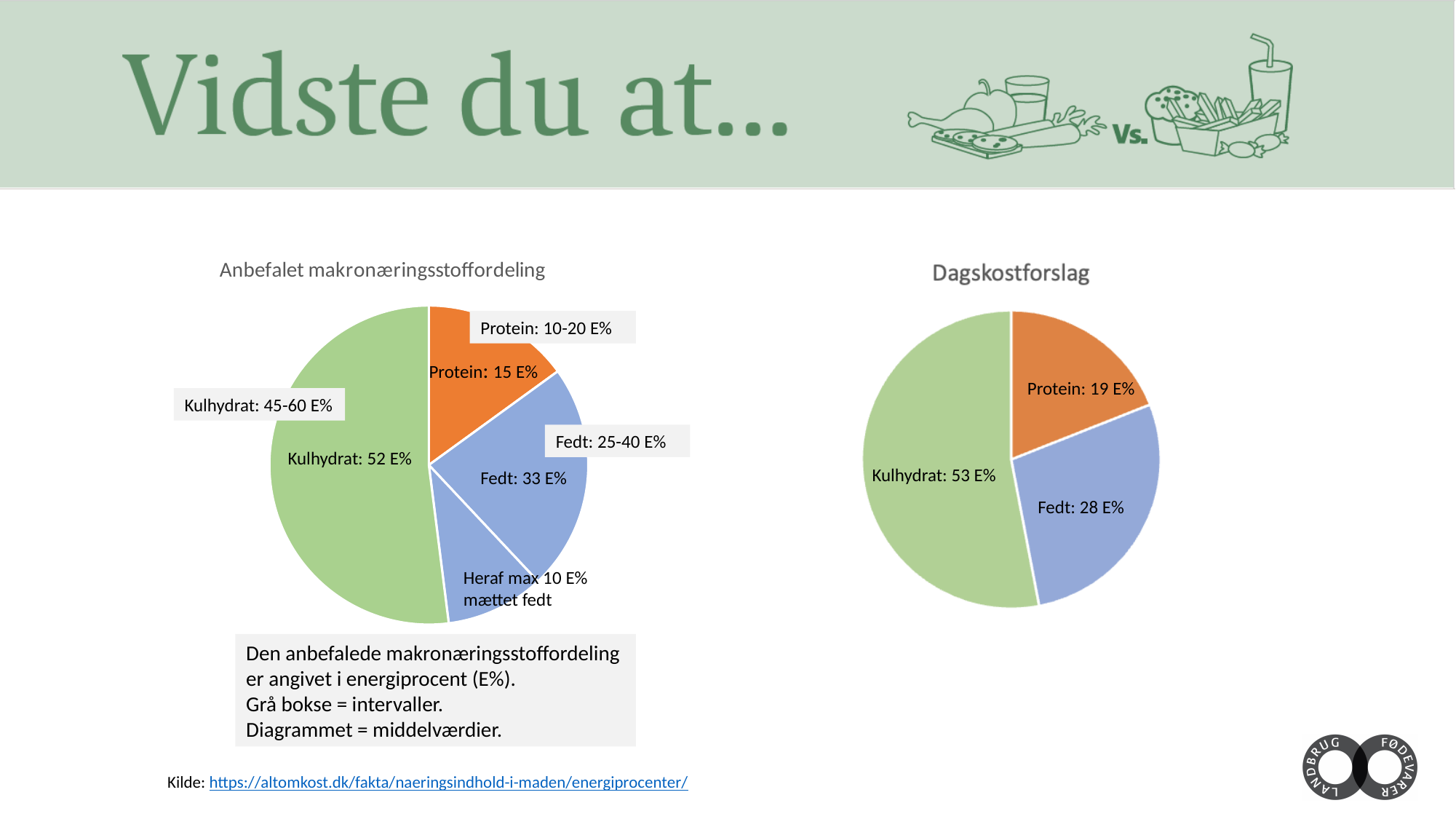
What kind of chart is the 'Dagskostforslag' chart? Pie chart In the 'Dagskostforslag' chart, which category has the largest slice? Kulhydrat In the 'Anbefalet makronæringsstoffordeling' chart, which category has the smallest slice? Mættet fedt (Heraf max 10 E% mættet fedt) In the 'Anbefalet makronæringsstoffordeling' chart, what is the value for Fedt? 33 E% In the 'Anbefalet makronæringsstoffordeling' chart, what interval is given in the grey box for Kulhydrat? 45-60 E% Which is larger: Protein in the 'Dagskostforslag' chart or Protein in the 'Anbefalet makronæringsstoffordeling' chart? Dagskostforslag In the 'Dagskostforslag' chart, what is the value for Protein? 19 E% In the 'Anbefalet makronæringsstoffordeling' chart, what is the value for Kulhydrat? 52 E% In the 'Dagskostforslag' chart, what is the difference between Kulhydrat and Fedt? 25 E% How many categories are shown in the 'Dagskostforslag' chart? 3 In the 'Dagskostforslag' chart, what is the value for Fedt? 28 E% In the 'Anbefalet makronæringsstoffordeling' chart, what is the difference between Fedt and Protein? 18 E%